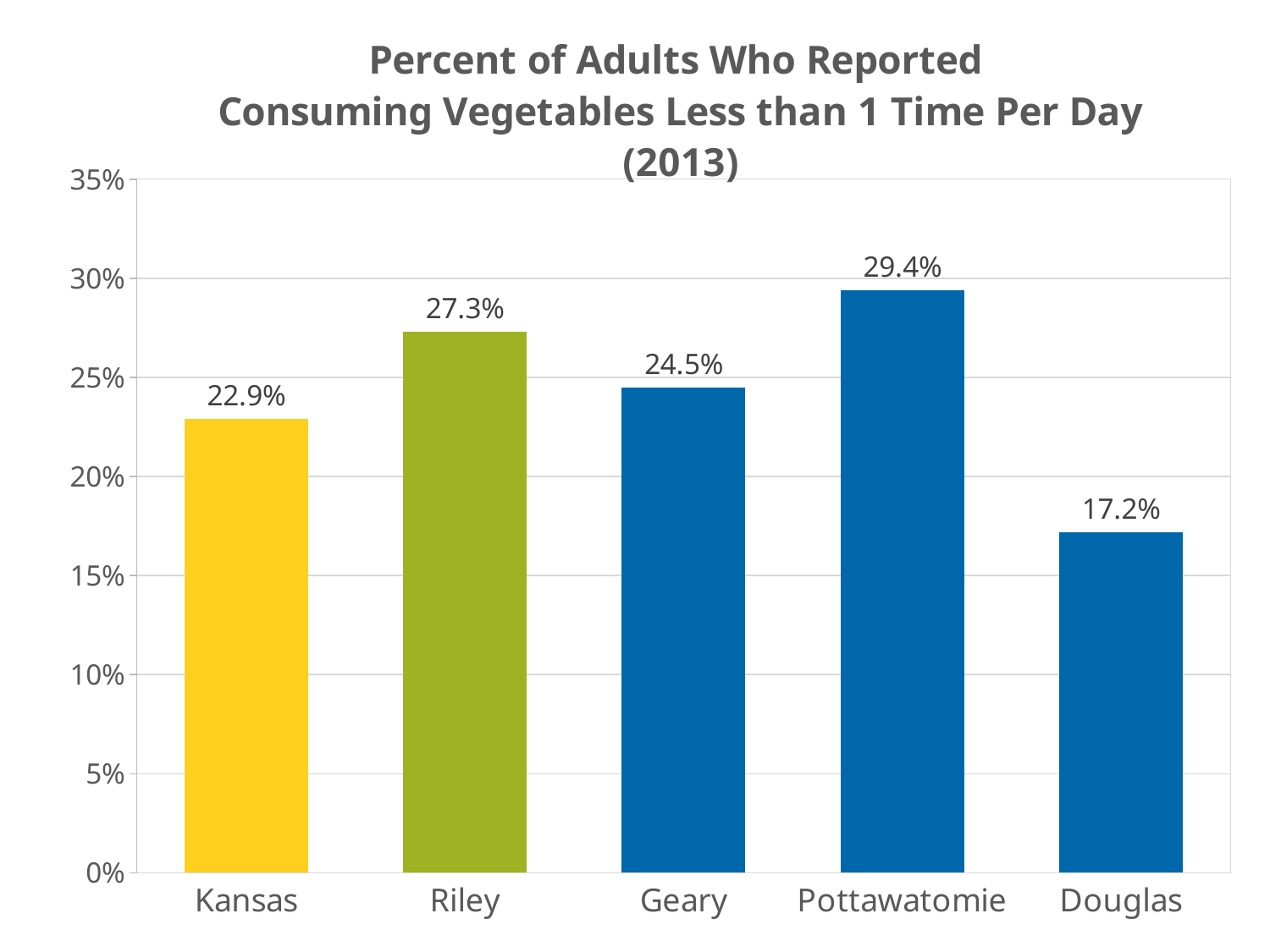
What is the value shown for Douglas? 17.2% Which category has the lowest percentage? Douglas What is the difference between the values for Riley and Kansas? 4.4% What year is given in the chart title? 2013 What kind of chart is shown on the slide? Bar chart What percent of adults in Riley reported consuming vegetables less than 1 time per day? 27.3% Is the value for Pottawatomie greater or less than 25%? greater Which category has the highest percentage? Pottawatomie How many categories are shown on the x axis? 5 Which is larger, the value for Geary or the value for Kansas? Geary What is the difference between the values for Pottawatomie and Douglas? 12.2% What is the value shown for Kansas? 22.9%